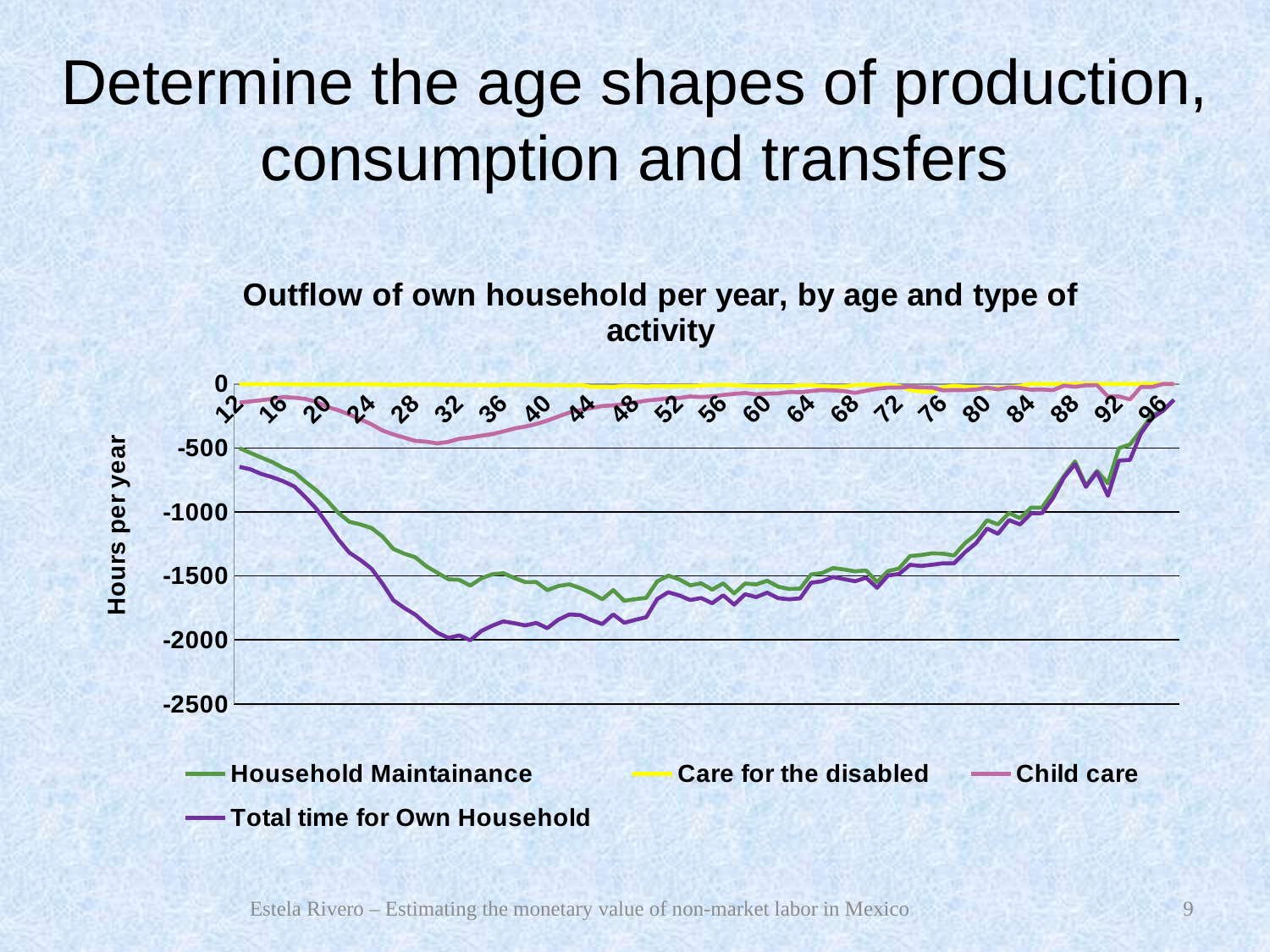
Is the value for Child care at age 60 greater or less than -500? greater Which series reaches the lowest value on the chart? Total time for Own Household What is the title of the chart? Outflow of own household per year, by age and type of activity Which series stays closest to 0 across all ages? Care for the disabled What kind of chart is shown on the slide? line chart How many series does the chart legend list? 4 What is the label on the vertical axis of the chart? Hours per year How many age labels are shown along the x axis of the chart? 22 At age 32, which series has the lower value: Household Maintainance or Total time for Own Household? Total time for Own Household Is the value for Total time for Own Household at age 28 greater or less than -1500? less Is the value for Household Maintainance at age 24 greater or less than -1500? greater Does the Total time for Own Household series rise or fall between age 32 and age 96? rise